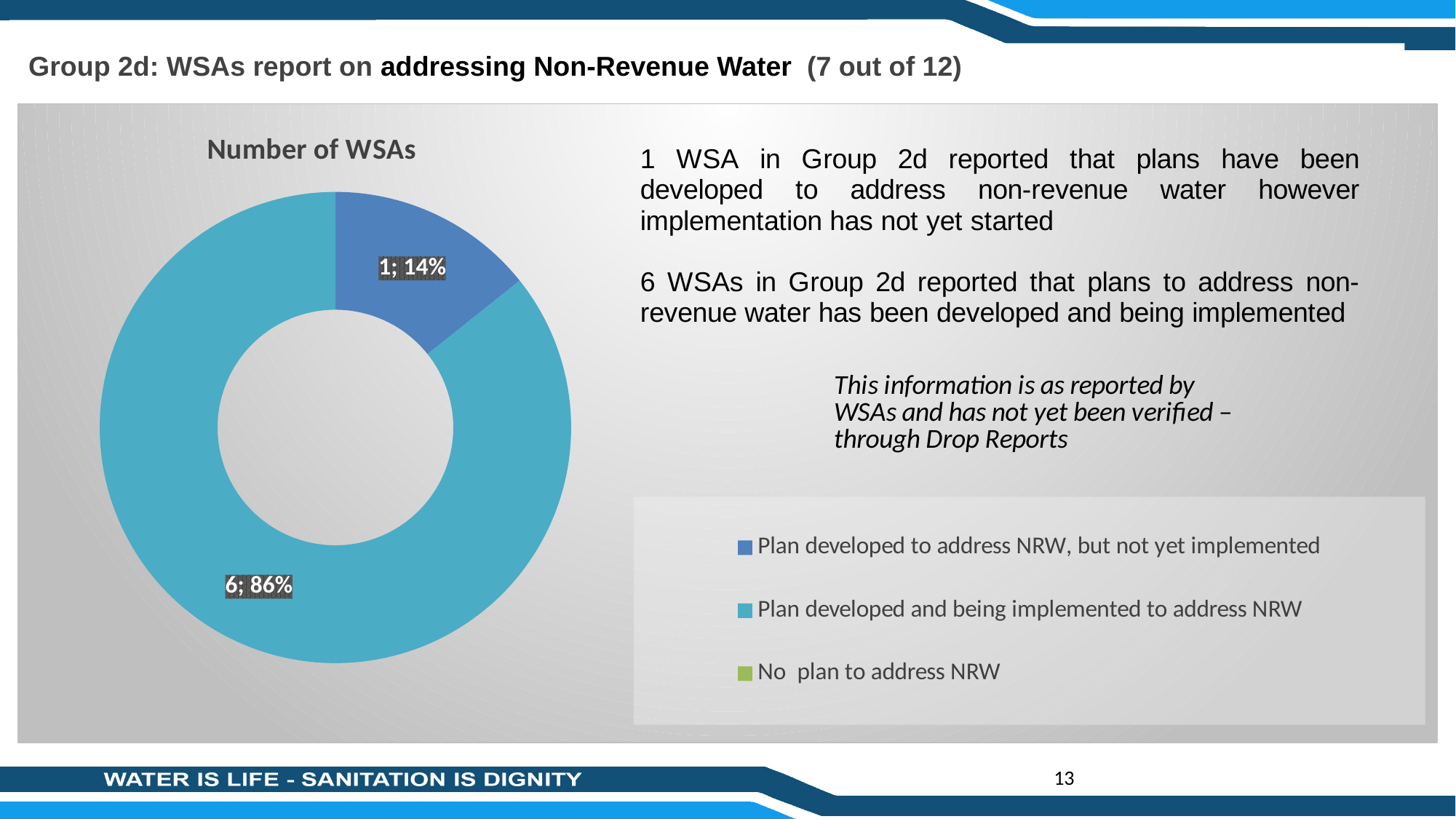
What share of the chart is the 'Plan developed and being implemented to address NRW' slice? 86% What is the difference in the number of WSAs between the 'Plan developed and being implemented' slice and the 'Plan developed but not yet implemented' slice? 5 Which is larger: the number of WSAs with a plan being implemented or the number with a plan not yet implemented? Plan being implemented What is the title of the chart? Number of WSAs Which of the two plotted categories has the smaller slice? Plan developed to address NRW, but not yet implemented Which category has the largest slice in the chart? Plan developed and being implemented to address NRW What kind of chart is shown on the slide? Doughnut (pie) chart How many entries does the chart's legend list? 3 How many WSAs reported a plan developed to address NRW, but not yet implemented? 1 How many WSAs reported a plan developed and being implemented to address NRW? 6 What share of the chart is the 'Plan developed to address NRW, but not yet implemented' slice? 14% What colour is the legend marker for 'No plan to address NRW'? Green